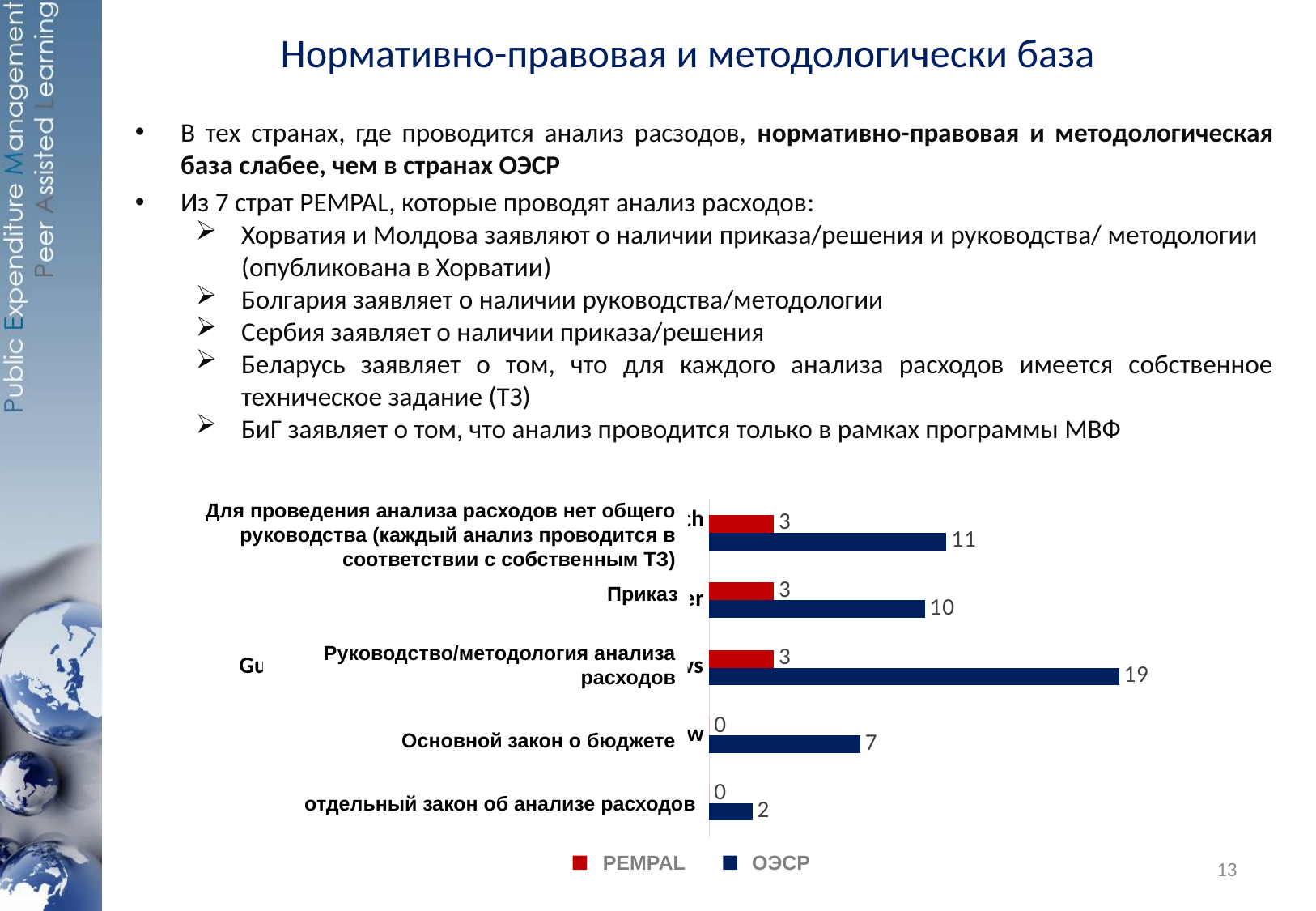
What is the PEMPAL value for "отдельный закон об анализе расходов"? 0 Which category has the lowest ОЭСР value? отдельный закон об анализе расходов Which is larger for "Приказ": the PEMPAL value or the ОЭСР value? ОЭСР Which category has the highest ОЭСР value? Руководство/методология анализа расходов What is the ОЭСР value for "Основной закон о бюджете"? 7 What is the ОЭСР value for "Руководство/методология анализа расходов"? 19 What is the difference between the ОЭСР values for "Приказ" and "Основной закон о бюджете"? 3 How many series does the legend list? 2 How many categories are shown in the chart? 5 What type of chart is shown on the slide? Bar chart What is the PEMPAL value for "Приказ"? 3 What is the difference between the ОЭСР and PEMPAL values for "Руководство/методология анализа расходов"? 16